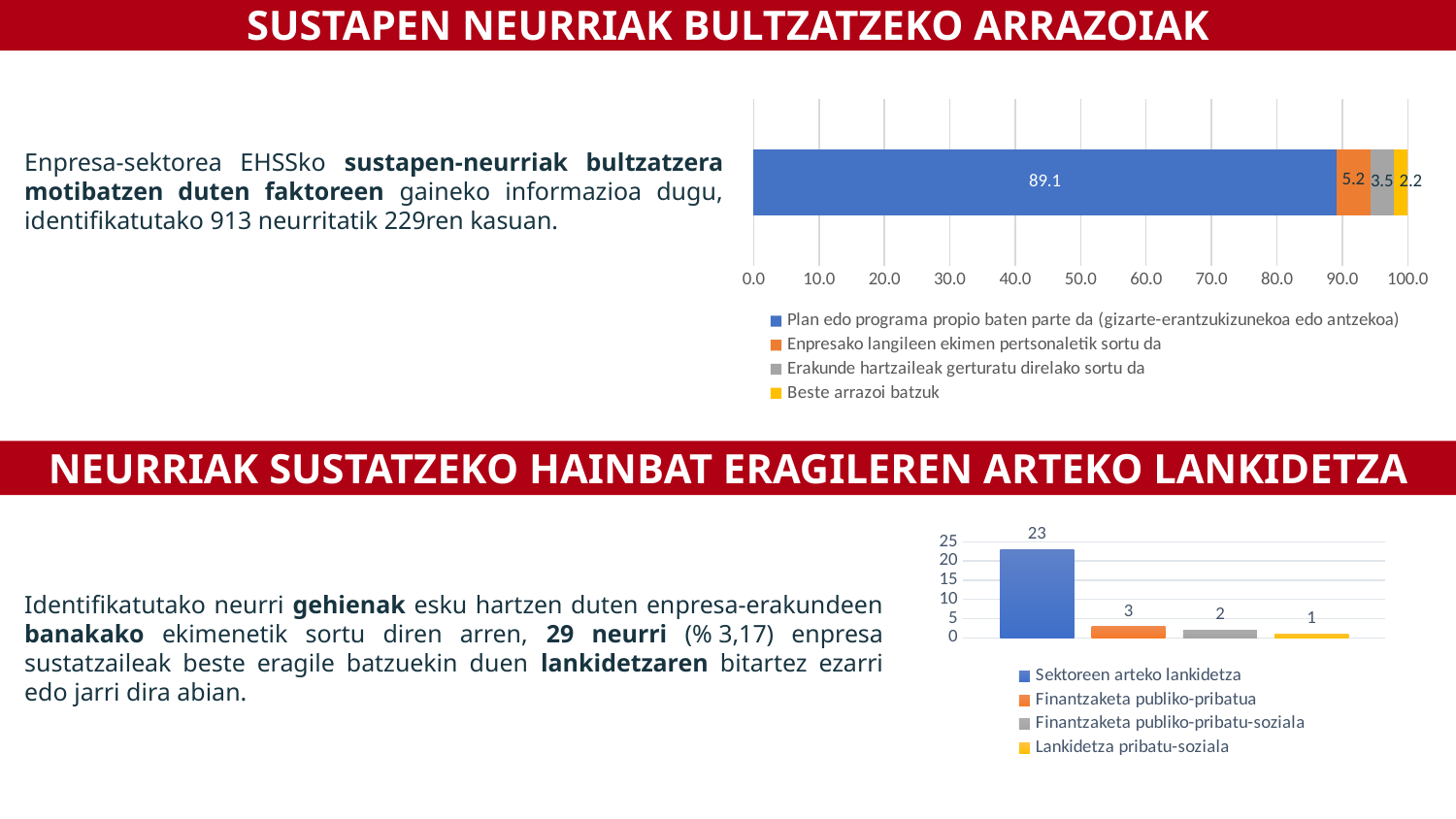
In the bottom chart, which series has the lowest value? Lankidetza pribatu-soziala How many series does the legend of the top chart list? 4 In the top chart, what is the value for 'Beste arrazoi batzuk'? 2.2 In the bottom chart, what is the value for 'Finantzaketa publiko-pribatu-soziala'? 2 In the bottom chart, what is the difference between 'Sektoreen arteko lankidetza' and 'Finantzaketa publiko-pribatua'? 20 In the top chart, what is the value for 'Enpresako langileen ekimen pertsonaletik sortu da'? 5.2 In the top chart, what is the difference between the values for 'Enpresako langileen ekimen pertsonaletik sortu da' and 'Erakunde hartzaileak gerturatu direlako sortu da'? 1.7 In the top chart, what is the value for 'Plan edo programa propio baten parte da (gizarte-erantzukizunekoa edo antzekoa)'? 89.1 In the top chart, which series has the largest value? Plan edo programa propio baten parte da (gizarte-erantzukizunekoa edo antzekoa) What kind of chart is the top chart? Stacked bar chart In the bottom chart, what is the value for 'Sektoreen arteko lankidetza'? 23 In the bottom chart, which is larger: 'Finantzaketa publiko-pribatua' or 'Lankidetza pribatu-soziala'? Finantzaketa publiko-pribatua